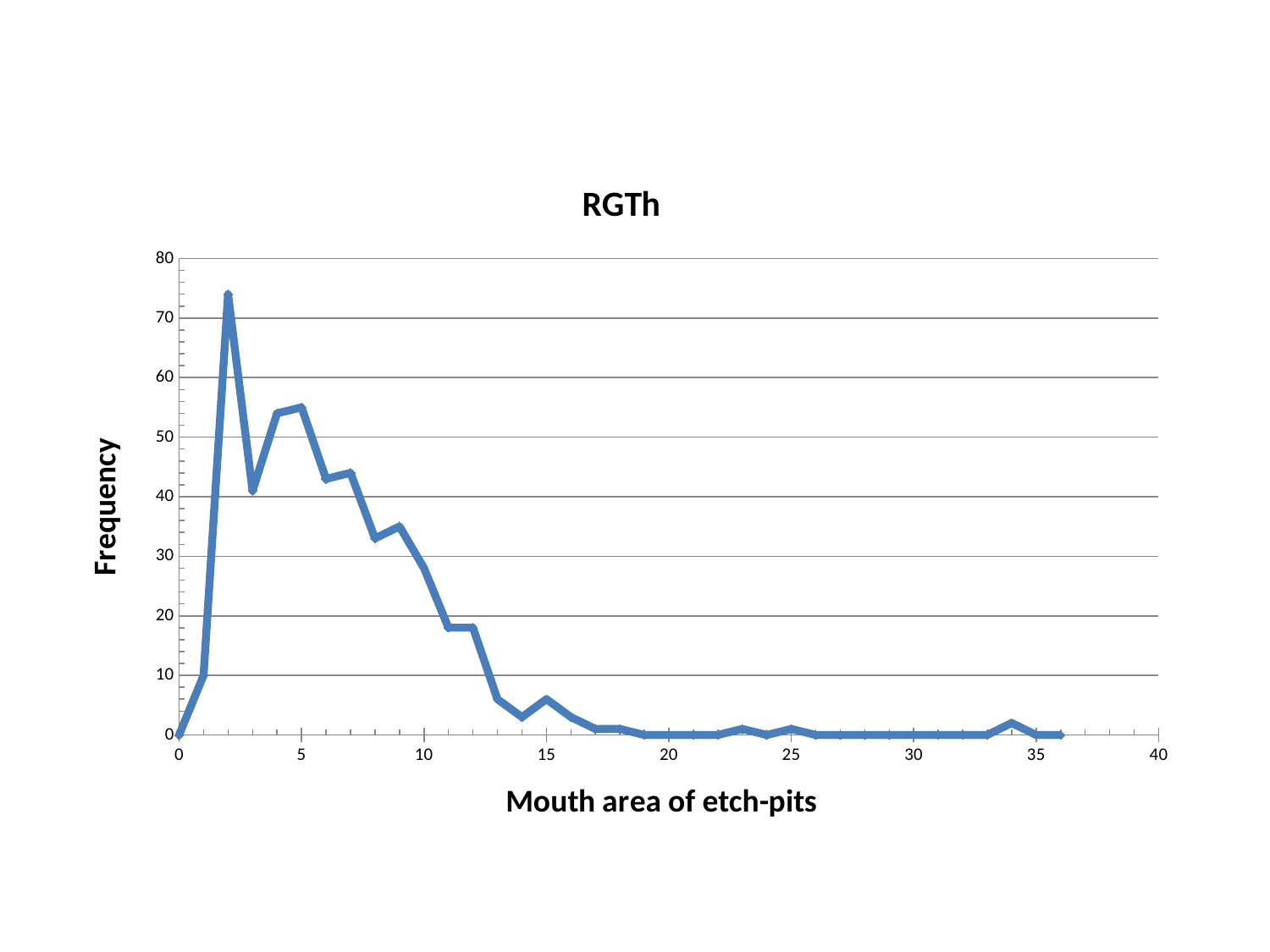
Is the frequency at a mouth area of 2 greater or less than 70? greater What is the label of the vertical axis? Frequency At which mouth area of etch-pits does the frequency reach its highest value? 2 Is the frequency at a mouth area of 10 greater or less than 20? greater Is the frequency at a mouth area of 5 greater or less than 50? greater What is the frequency at a mouth area of 0? 0 What kind of chart is shown on the slide? line chart Which has the higher frequency: a mouth area of 2 or a mouth area of 5? 2 What is the title of the chart? RGTh Between mouth areas of 10 and 20, does the frequency generally rise or fall? fall